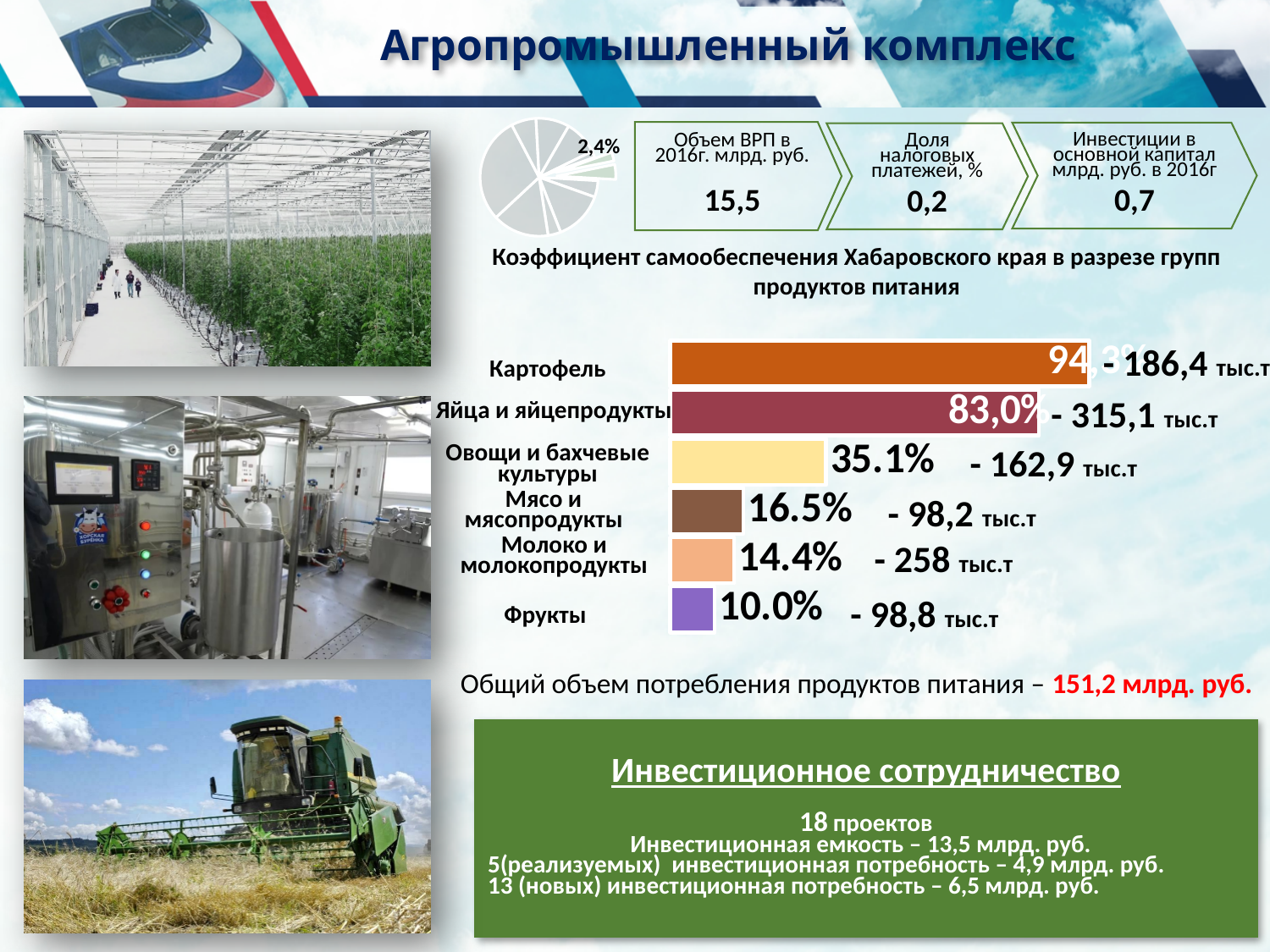
In the bar chart 'Коэффициент самообеспечения', what is the value for Мясо и мясопродукты? 16.5% In the bar chart 'Коэффициент самообеспечения', which is larger: the value for Мясо и мясопродукты or for Молоко и молокопродукты? Мясо и мясопродукты In the bar chart 'Коэффициент самообеспечения', which product group has the lowest value? Фрукты In the bar chart 'Коэффициент самообеспечения', what is the difference between the values for Овощи и бахчевые культуры and Мясо и мясопродукты? 18.6% In the bar chart 'Коэффициент самообеспечения', what is the value for Фрукты? 10.0% In the bar chart 'Коэффициент самообеспечения', what is the value for Яйца и яйцепродукты? 83,0% What kind of chart is used for 'Коэффициент самообеспечения Хабаровского края в разрезе групп продуктов питания'? Bar chart In the bar chart 'Коэффициент самообеспечения', how many product groups are shown? 6 In the bar chart 'Коэффициент самообеспечения', what is the value for Овощи и бахчевые культуры? 35.1% In the bar chart 'Коэффициент самообеспечения', which product group has the highest value? Картофель In the small pie chart at the top of the slide, what value is printed next to the highlighted slice? 2,4% In the bar chart 'Коэффициент самообеспечения', what is the value for Молоко и молокопродукты? 14.4%